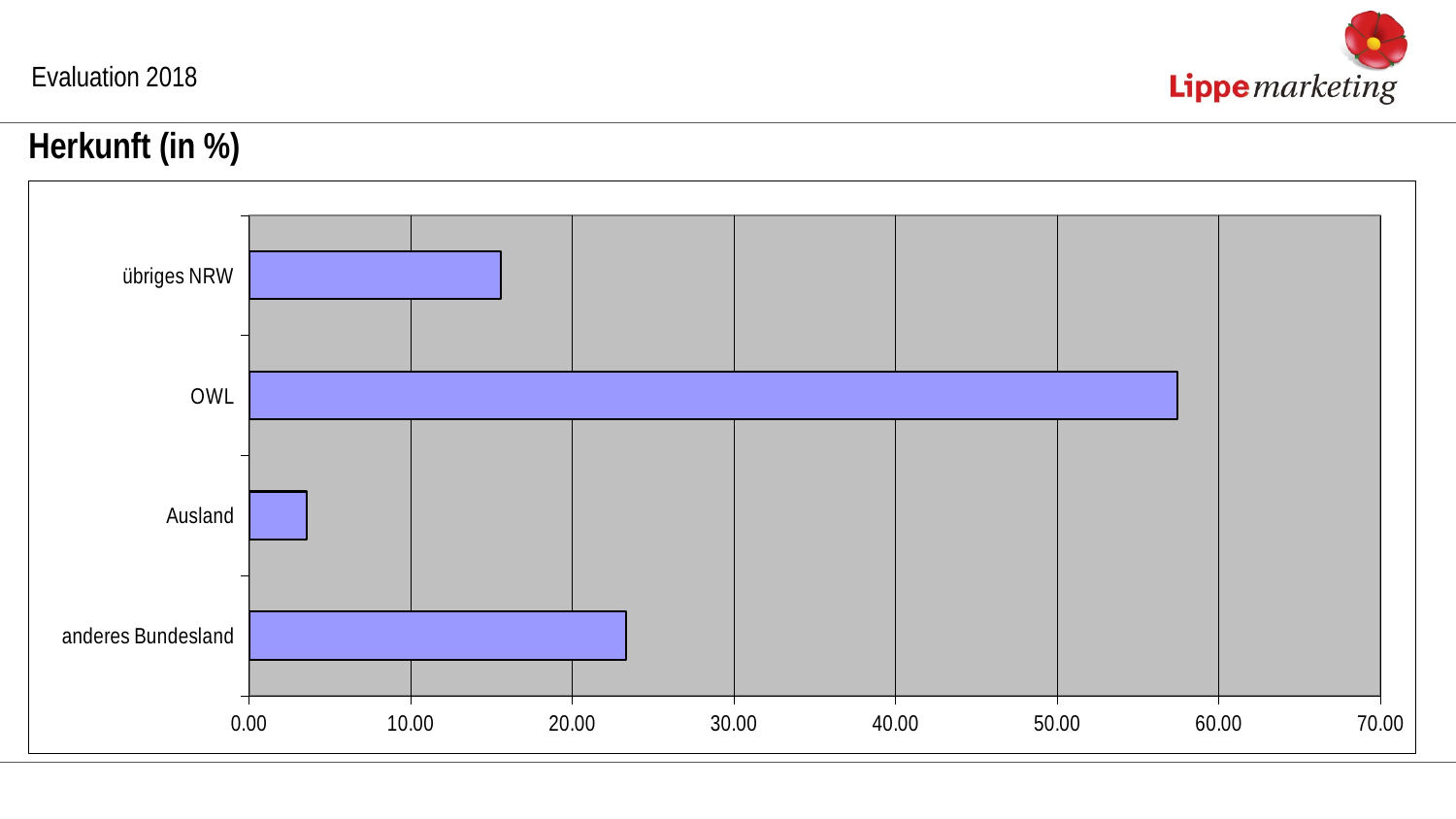
Which category has the highest value? OWL Which category has the lowest value? Ausland How many categories are shown in the chart? 4 What is the maximum value shown on the x axis? 70.00 Is the value for OWL greater or less than 50.00? greater Is the value for Ausland greater or less than 10.00? less Which is larger, the value for anderes Bundesland or the value for übriges NRW? anderes Bundesland Is the value for OWL greater or less than 60.00? less What kind of chart is shown on the slide? bar chart What is the title of the chart? Herkunft (in %)